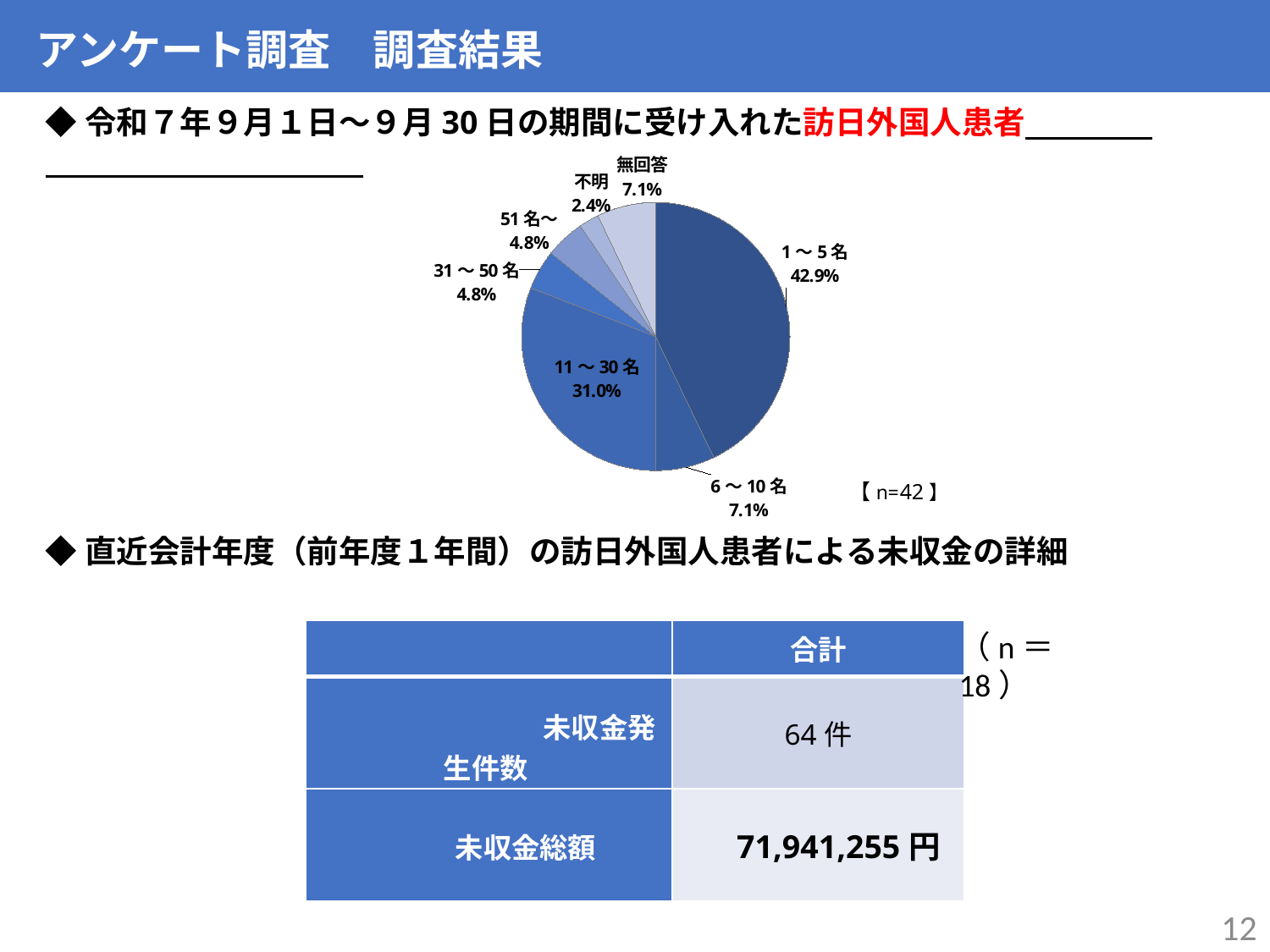
How many slices does the pie chart have? 7 What kind of chart is shown on the slide? pie chart What is the value shown for 不明 in the pie chart? 2.4% Which is larger in the pie chart, the 6～10名 slice or the 31～50名 slice? 6～10名 What share of the pie chart does the 1～5名 slice represent? 42.9% Which category has the smallest slice in the pie chart? 不明 What sample size (n) is noted next to the pie chart? n=42 What share of the pie chart does the 11～30名 slice represent? 31.0% What is the value shown for 無回答 in the pie chart? 7.1% What is the difference in percentage points between the 1～5名 slice and the 11～30名 slice? 11.9 Which category has the largest slice in the pie chart? 1～5名 What is the value shown for 6～10名 in the pie chart? 7.1%